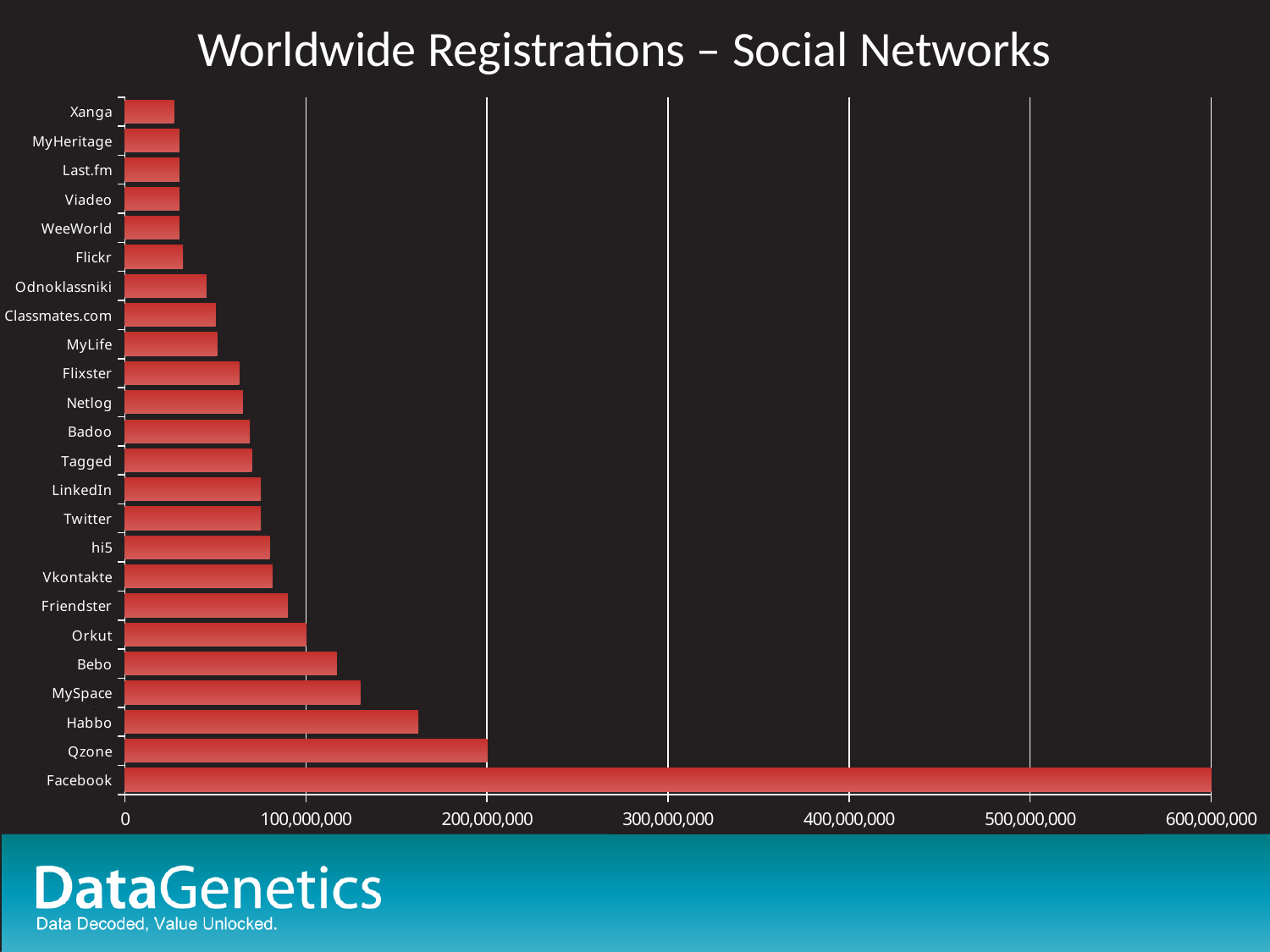
Which social network has the highest number of worldwide registrations? Facebook Which has more registrations, Habbo or MySpace? Habbo What kind of chart is shown on the slide? bar chart Is the value for Friendster greater or less than 100,000,000? less How many social networks are listed on the chart? 24 What is the value for Facebook? 600,000,000 Is the value for Habbo greater or less than 100,000,000? greater What is the value for Orkut? 100,000,000 What is the difference between the values for Facebook and Qzone? 400,000,000 What is the title of the chart? Worldwide Registrations – Social Networks What is the value for Qzone? 200,000,000 Is the value for Habbo greater or less than 200,000,000? less